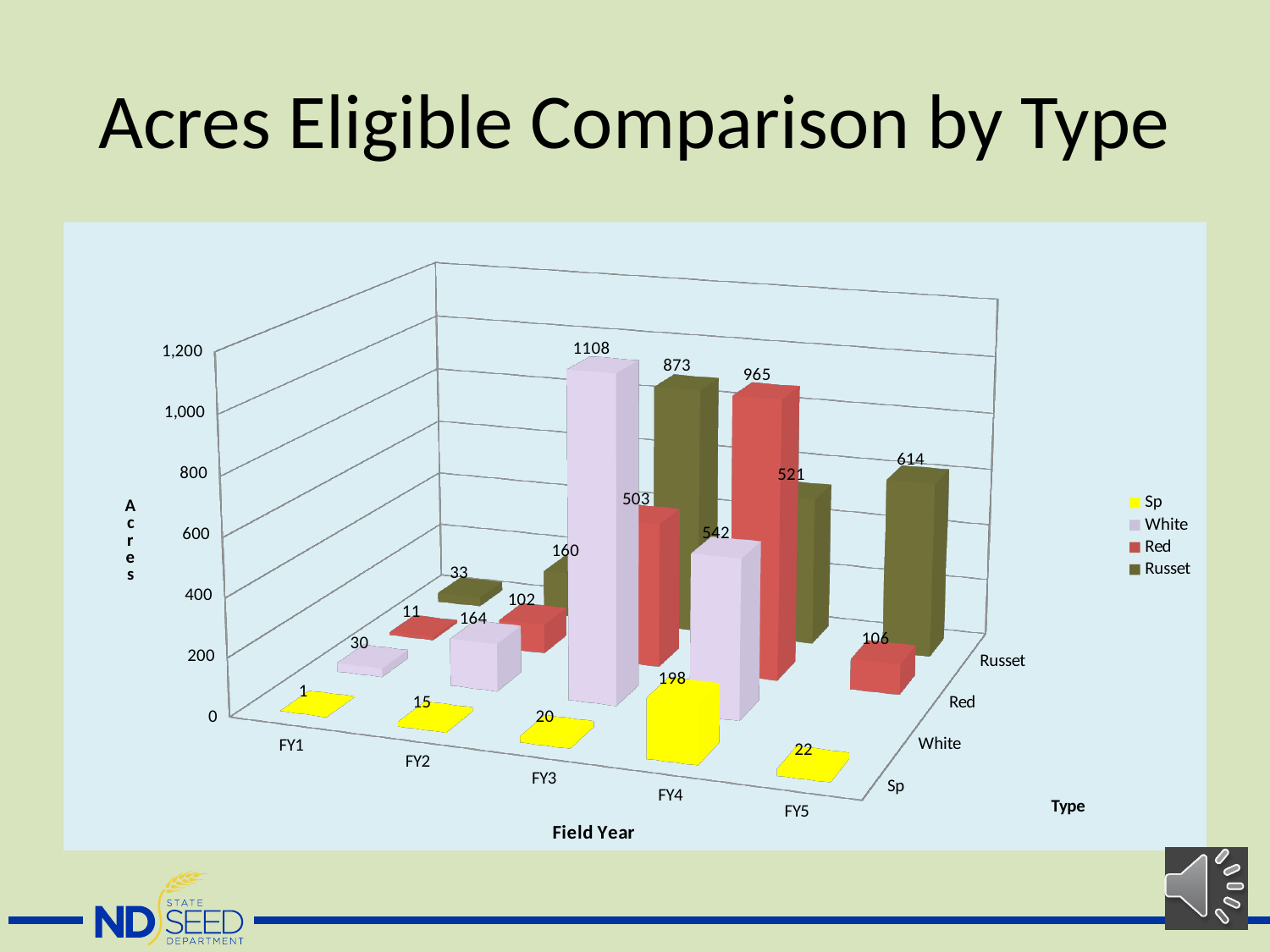
What is the title of the chart on the slide? Acres Eligible Comparison by Type How many field years are shown on the Field Year axis? 5 Which field year has the highest value for Russet? FY3 What kind of chart is shown on the slide? Bar chart What is the value for Sp in FY4? 198 Which field year has the lowest value for Sp? FY1 What is the value for Russet in FY5? 614 Which is larger, the White value in FY4 or the Russet value in FY4? White value in FY4 What is the difference between the Red values for FY4 and FY3? 462 What is the value for Red in FY4? 965 How many series does the legend list? 4 What is the value for White in FY3? 1108